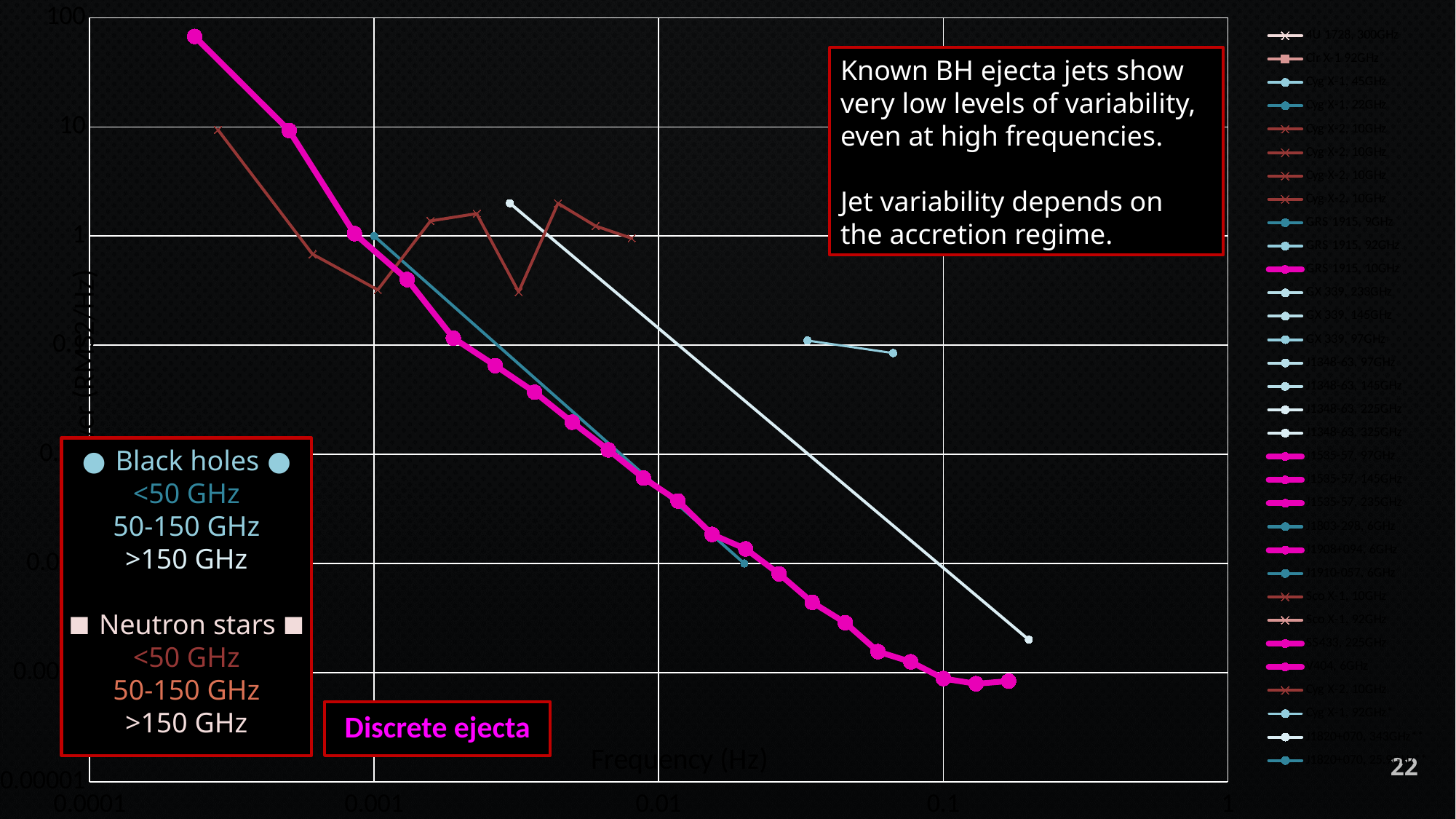
At a frequency of 0.001 Hz, is the value of the thick magenta line greater or less than 10? less What text appears in the small red-bordered box near the bottom of the chart? Discrete ejecta Does the thick magenta line rise or fall as frequency increases along the x axis? fall What kind of chart is shown on the slide? line chart What is the label of the x axis? Frequency (Hz) Which line reaches the highest value on the chart? the thick magenta line How many labelled tick marks are shown on the x axis? 5 Does the long light-blue line running from about 0.003 Hz to about 0.15 Hz rise or fall as frequency increases? fall At a frequency of 0.0005 Hz, which is larger: the thick magenta line or the brown line? the thick magenta line Is the highest point of the brown line (near 0.005 Hz) greater or less than 10? less